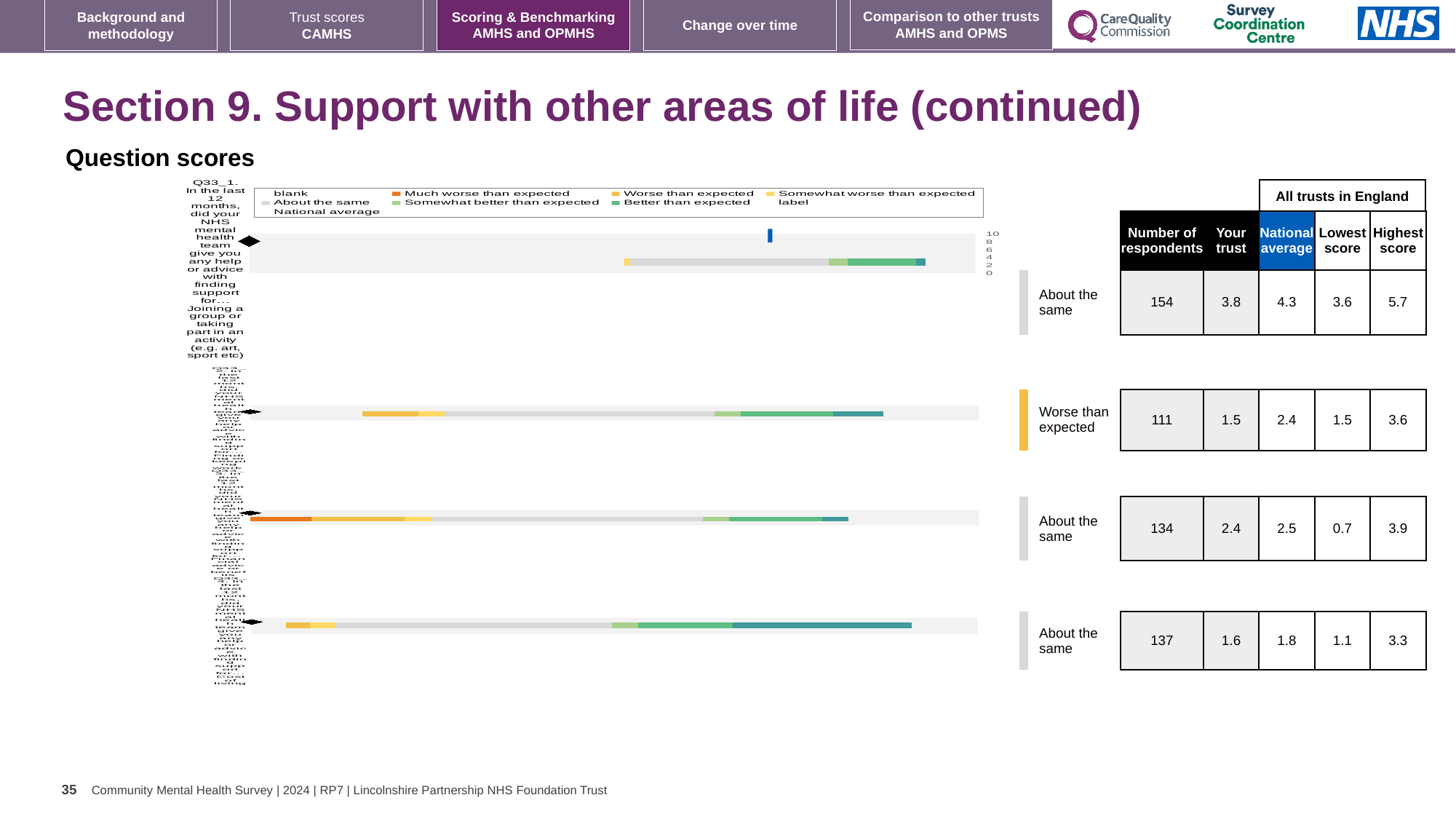
How many entries does the chart's legend list? 9 For the first (top) row, which is larger: the 'Your trust' score or the national average? National average What benchmark category is shown for the second bar in the chart? Worse than expected In the table beside the chart, what is the 'Your trust' score for the first (top) row? 3.8 In the table beside the chart, what is the national average for the first (top) row? 4.3 What colour does the legend use for 'Much worse than expected'? Orange For the first (top) row, what is the difference between the highest score and the lowest score in the table? 2.1 Which row in the table beside the chart has the highest 'Your trust' score? The first (top) row, 3.8 What is the question code of the first (top) bar in the chart? Q33_1 How many horizontal bars (question rows) are plotted in the chart? 4 In the table beside the chart, how many respondents are listed for the second row? 111 What kind of chart is shown under 'Question scores'? Bar chart